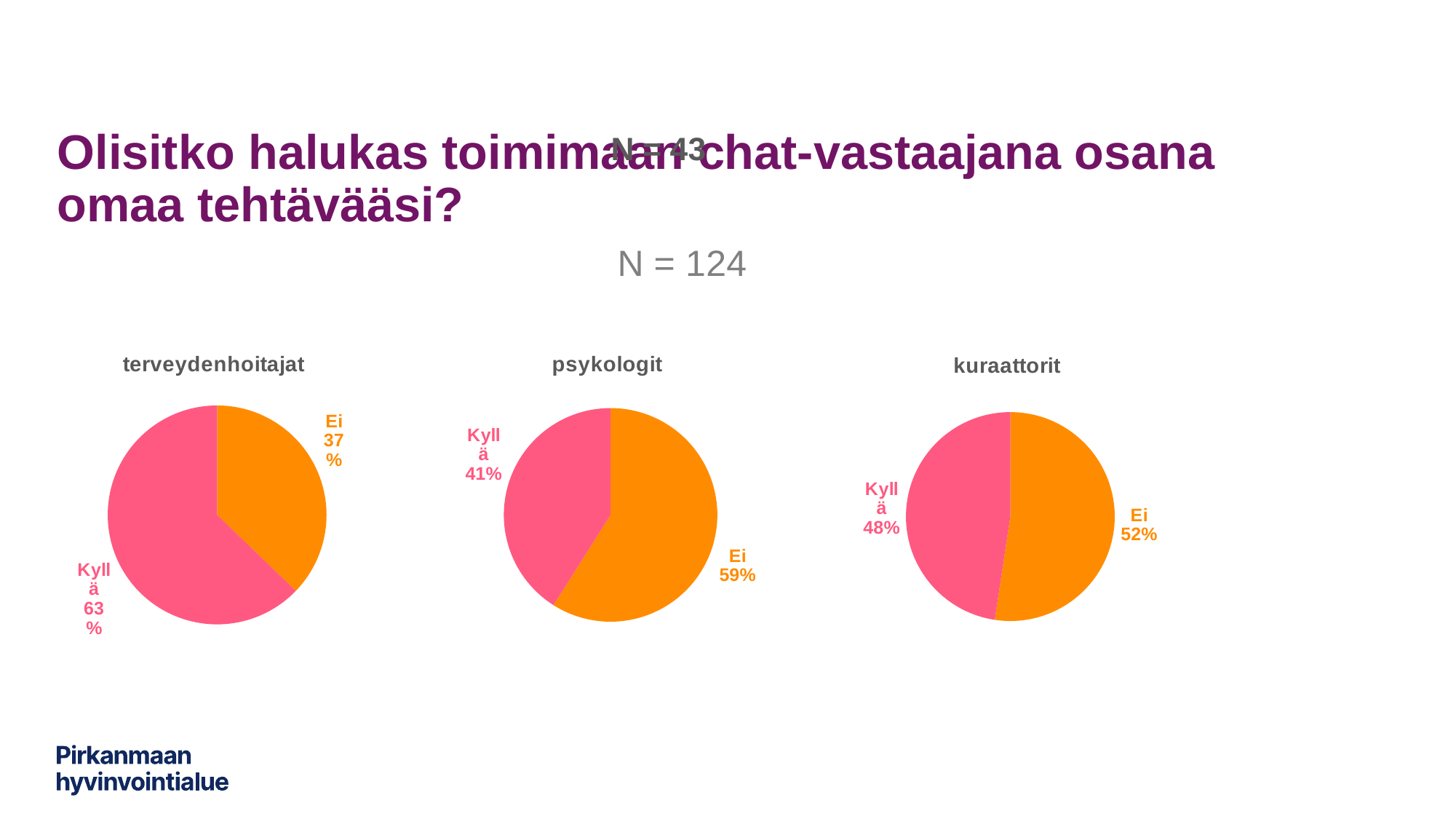
In the 'terveydenhoitajat' pie chart, what is the difference between the 'Kyllä' and 'Ei' shares? 26% In the 'psykologit' pie chart, which is larger, 'Kyllä' or 'Ei'? Ei In the 'terveydenhoitajat' pie chart, what share is labelled 'Ei'? 37% In the 'psykologit' pie chart, what share is labelled 'Kyllä'? 41% In the 'kuraattorit' pie chart, what share is labelled 'Ei'? 52% What kind of chart is used for 'psykologit'? Pie chart How many slices does the 'kuraattorit' pie chart have? 2 In the 'psykologit' pie chart, which slice is the smallest? Kyllä In the 'terveydenhoitajat' pie chart, which slice is the largest? Kyllä